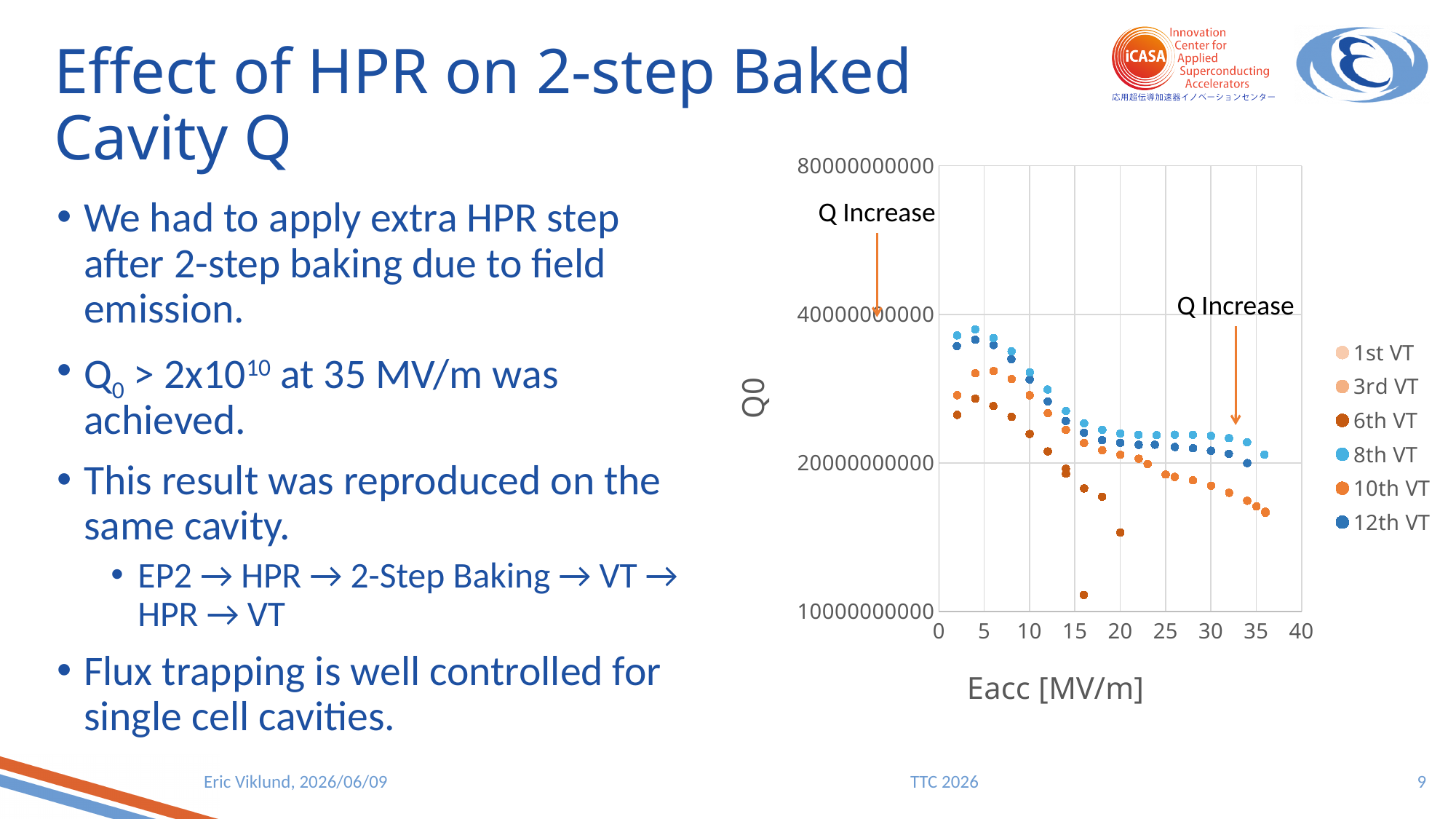
Is the Q0 value for the 8th VT series at 4 MV/m greater or less than 20000000000? greater Do the Q0 values for the 10th VT series rise or fall as Eacc increases? fall At 35 MV/m, which series has the higher Q0: 8th VT or 10th VT? 8th VT Which series contains the lowest Q0 point plotted on the chart? 6th VT How many series does the legend list? 6 What is the label of the y axis? Q0 Is the Q0 value for the 10th VT series at 35 MV/m greater or less than 20000000000? less Is the Q0 value for the 8th VT series at 35 MV/m greater or less than 20000000000? greater What is the label of the x axis? Eacc [MV/m] What kind of chart is shown on the slide? scatter chart At 20 MV/m, which series has the higher Q0: 6th VT or 8th VT? 8th VT